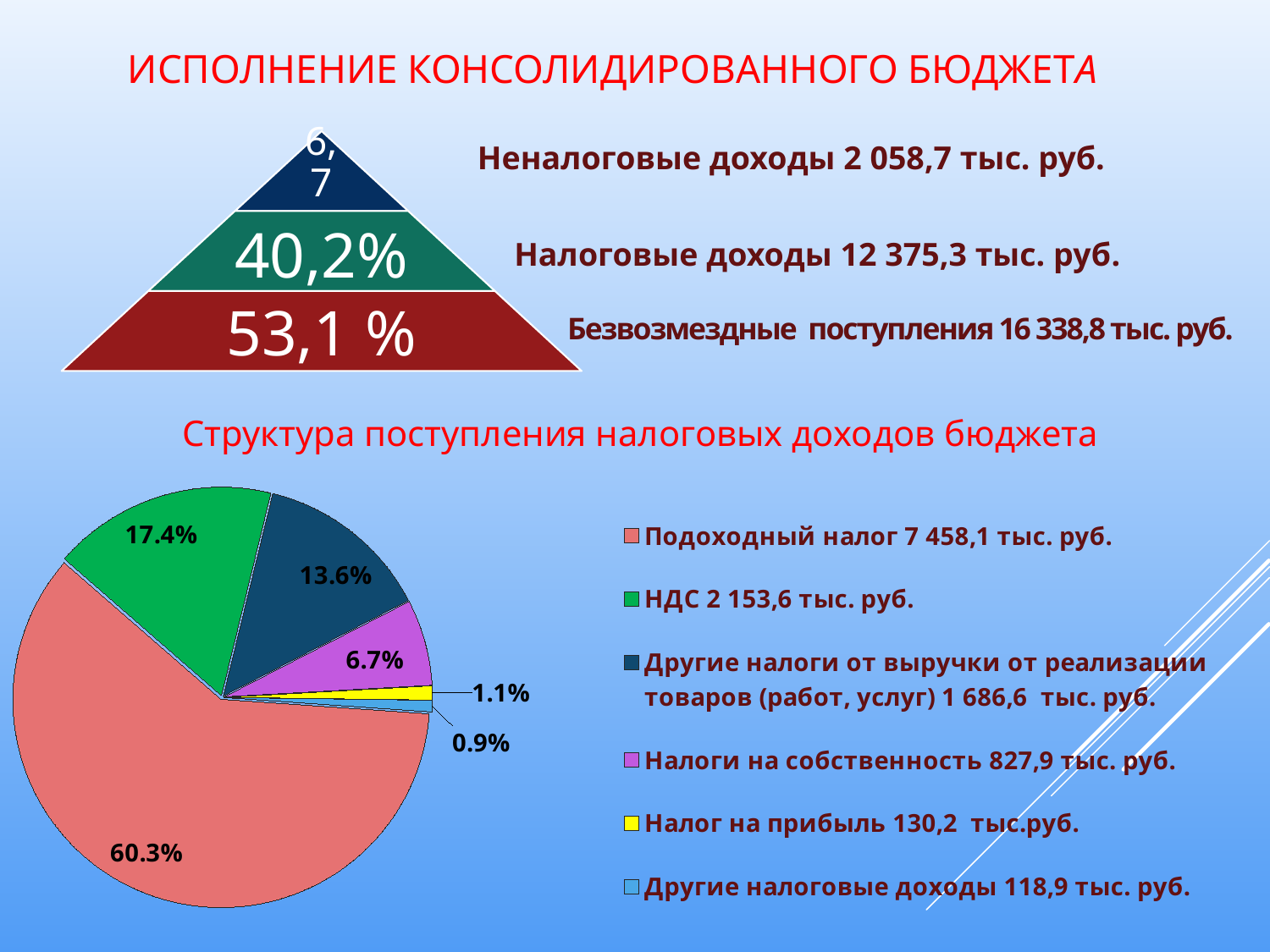
In the pie chart, what share is shown for 'Другие налоги от выручки от реализации товаров (работ, услуг)'? 13.6% In the pie chart, which slice is larger: 'НДС' or 'Налоги на собственность'? НДС In the pie chart, what share is shown for 'Подоходный налог'? 60.3% In the pie chart, what share is shown for 'Налог на прибыль'? 1.1% What kind of chart is shown under the heading 'Структура поступления налоговых доходов бюджета'? Pie chart Which category has the smallest slice in the pie chart? Другие налоговые доходы Which category has the largest slice in the pie chart? Подоходный налог How many slices does the pie chart have? 6 In the pie chart, what share is shown for 'Налоги на собственность'? 6.7% In the pie chart, by how many percentage points does the share of 'Подоходный налог' exceed the share of 'НДС'? 42.9 In the pie chart, what share is shown for 'НДС'? 17.4% How many entries does the legend of the pie chart list? 6